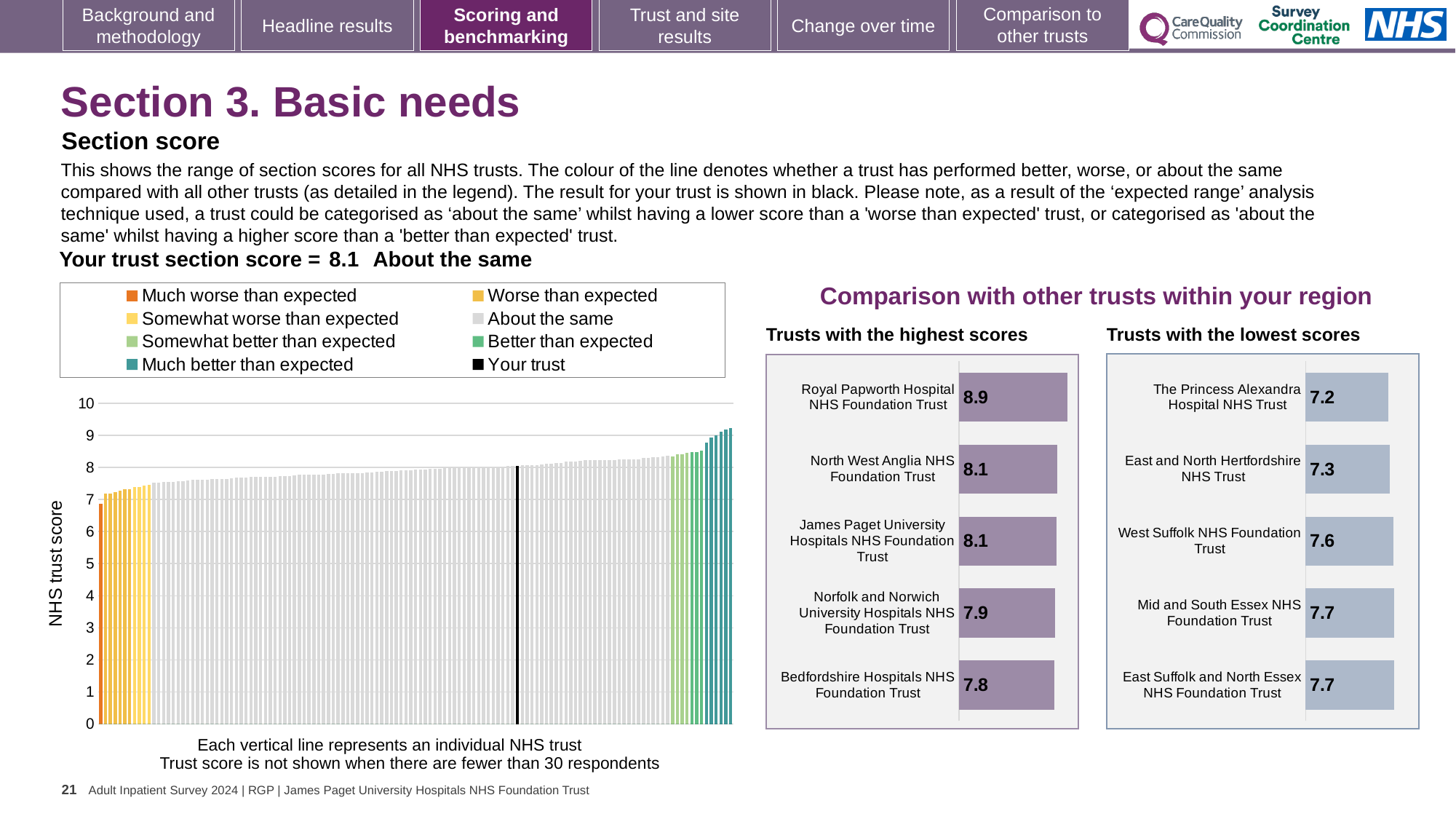
In the NHS trust score chart on the left, what colour is used for the bar representing your trust? Black In the NHS trust score chart on the left, do the values rise or fall from left to right? Rise How many trusts are shown in the 'Trusts with the highest scores' chart? 5 What kind of chart is the NHS trust score chart on the left of the slide? Bar chart How many entries does the legend of the NHS trust score chart on the left list? 8 In the 'Trusts with the highest scores' chart, what is the difference between the scores of Royal Papworth Hospital NHS Foundation Trust and Bedfordshire Hospitals NHS Foundation Trust? 1.1 In the 'Trusts with the highest scores' chart, what is the score for Royal Papworth Hospital NHS Foundation Trust? 8.9 In the 'Trusts with the lowest scores' chart, how much higher is West Suffolk NHS Foundation Trust's score than The Princess Alexandra Hospital NHS Trust's score? 0.4 In the 'Trusts with the highest scores' chart, which has the larger score: Norfolk and Norwich University Hospitals NHS Foundation Trust or Bedfordshire Hospitals NHS Foundation Trust? Norfolk and Norwich University Hospitals NHS Foundation Trust In the 'Trusts with the lowest scores' chart, what is the score for The Princess Alexandra Hospital NHS Trust? 7.2 In the 'Trusts with the lowest scores' chart, which trust has the lowest score? The Princess Alexandra Hospital NHS Trust In the 'Trusts with the highest scores' chart, which trust has the highest score? Royal Papworth Hospital NHS Foundation Trust